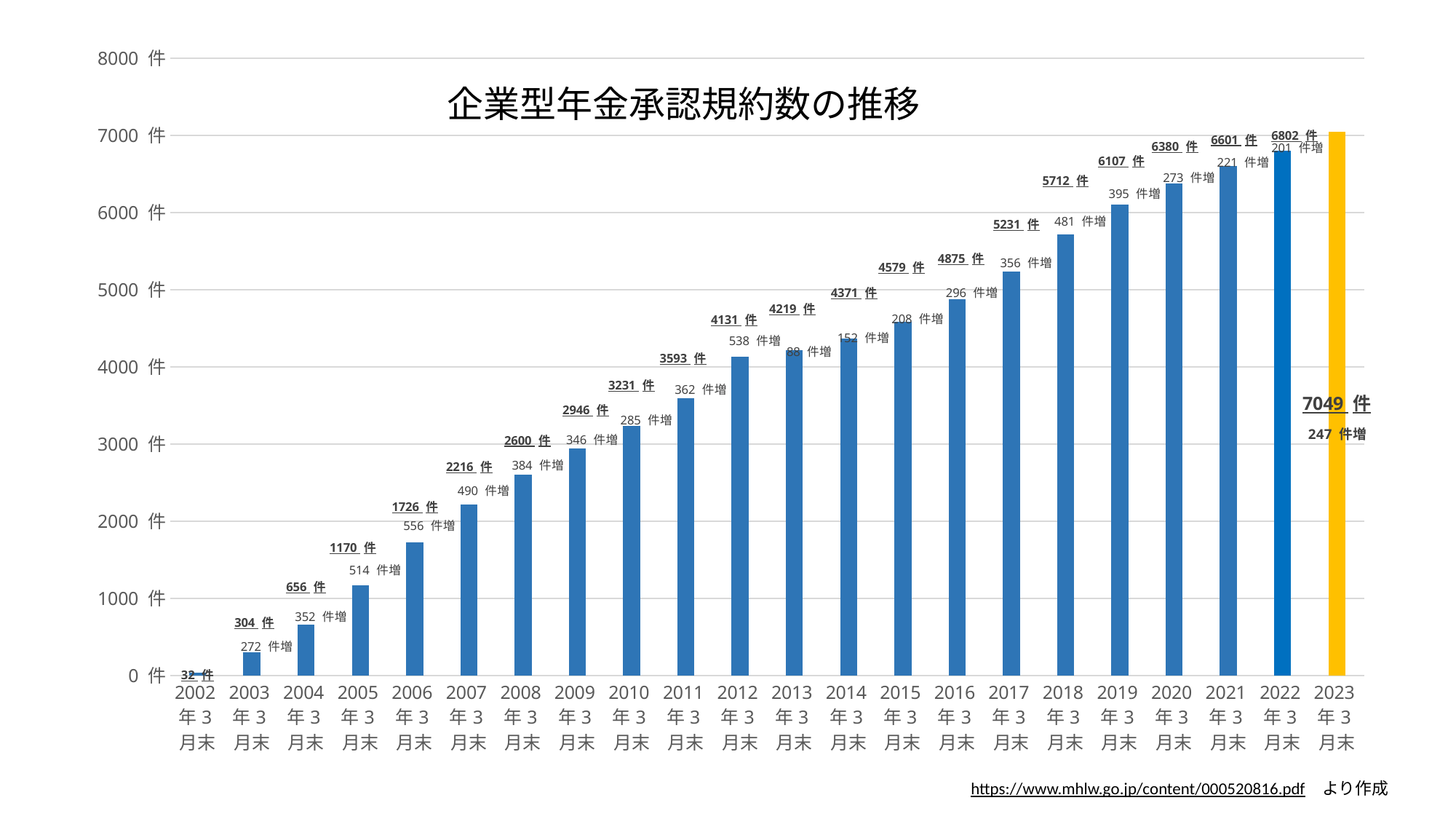
What is the value for 2023年3月末? 7049 件 What is the value for 2012年3月末? 4131 件 Which is larger, the value for 2010年3月末 or the value for 2011年3月末? 2011年3月末 Which year has the lowest value? 2002年3月末 What is the difference between the values for 2022年3月末 and 2021年3月末? 201 件 What is the title of the chart? 企業型年金承認規約数の推移 Do the values rise or fall from 2002 to 2023 along the x axis? rise Which year has the highest value? 2023年3月末 What is the value for 2005年3月末? 1170 件 How many bars (years) are plotted in the chart? 22 Which bar is coloured differently (yellow) from the others? 2023年3月末 What kind of chart is shown on the slide? bar chart